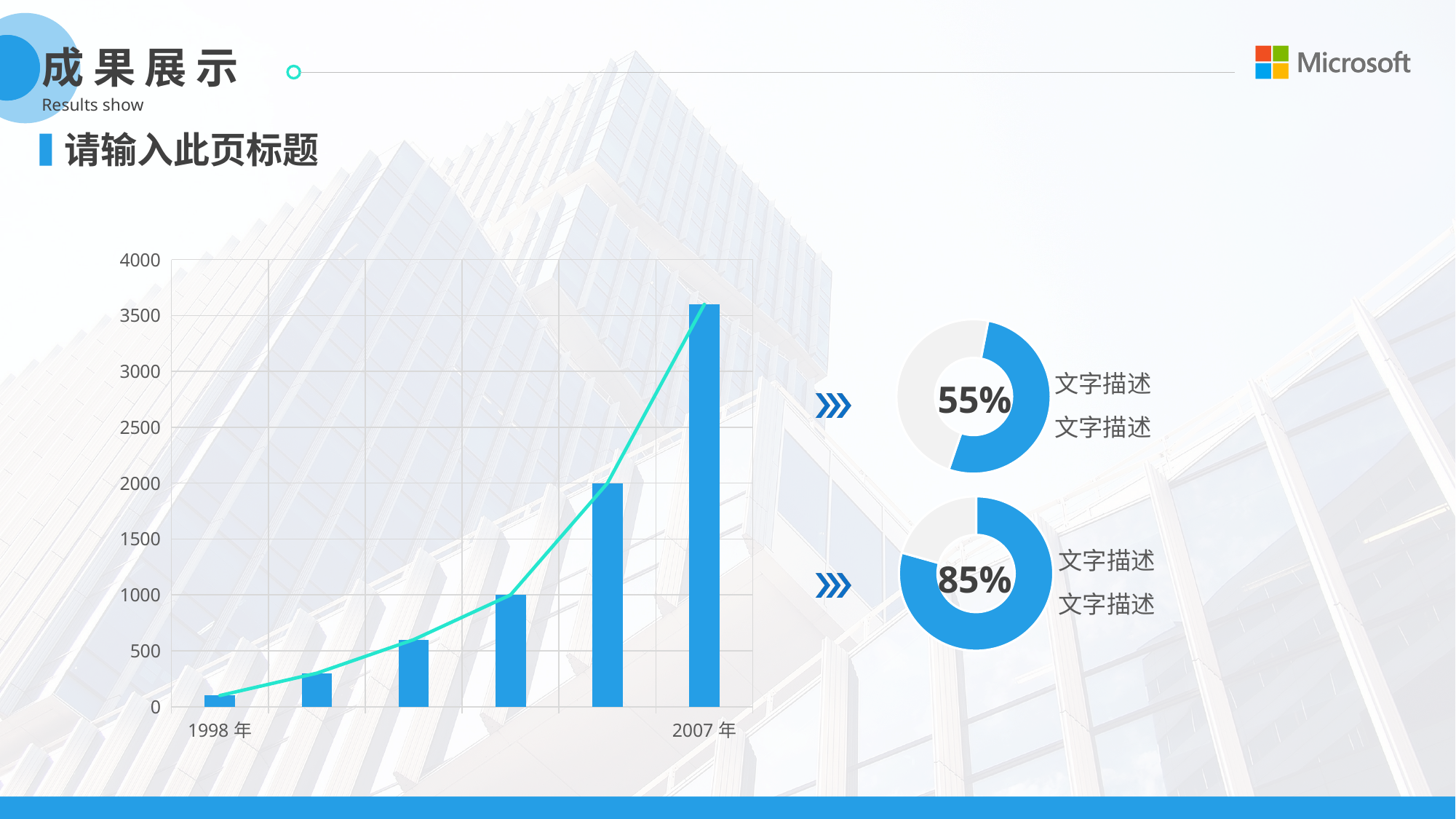
In the bar chart on the left, which category has the highest bar? 2007 年 In the bar chart on the left, what is the label of the last category on the x axis? 2007 年 Which of the two donut charts on the right shows the larger percentage, the upper one or the lower one? The lower one (85%) What kind of chart is the large chart on the left of the slide? A bar chart with a line overlay In the bar chart on the left, how many bars are plotted? 6 In the bar chart on the left, what is the highest value shown on the y axis? 4000 In the bar chart on the left, is the value of the bar for 2007 年 greater or less than 3500? greater In the bar chart on the left, do the bar values rise or fall from 1998 年 to 2007 年? Rise In the bar chart on the left, which category has the lowest bar? 1998 年 In the bar chart on the left, what is the label of the first category on the x axis? 1998 年 What percentage is shown in the upper donut chart on the right? 55% In the bar chart on the left, is the value of the bar for 1998 年 greater or less than 500? less